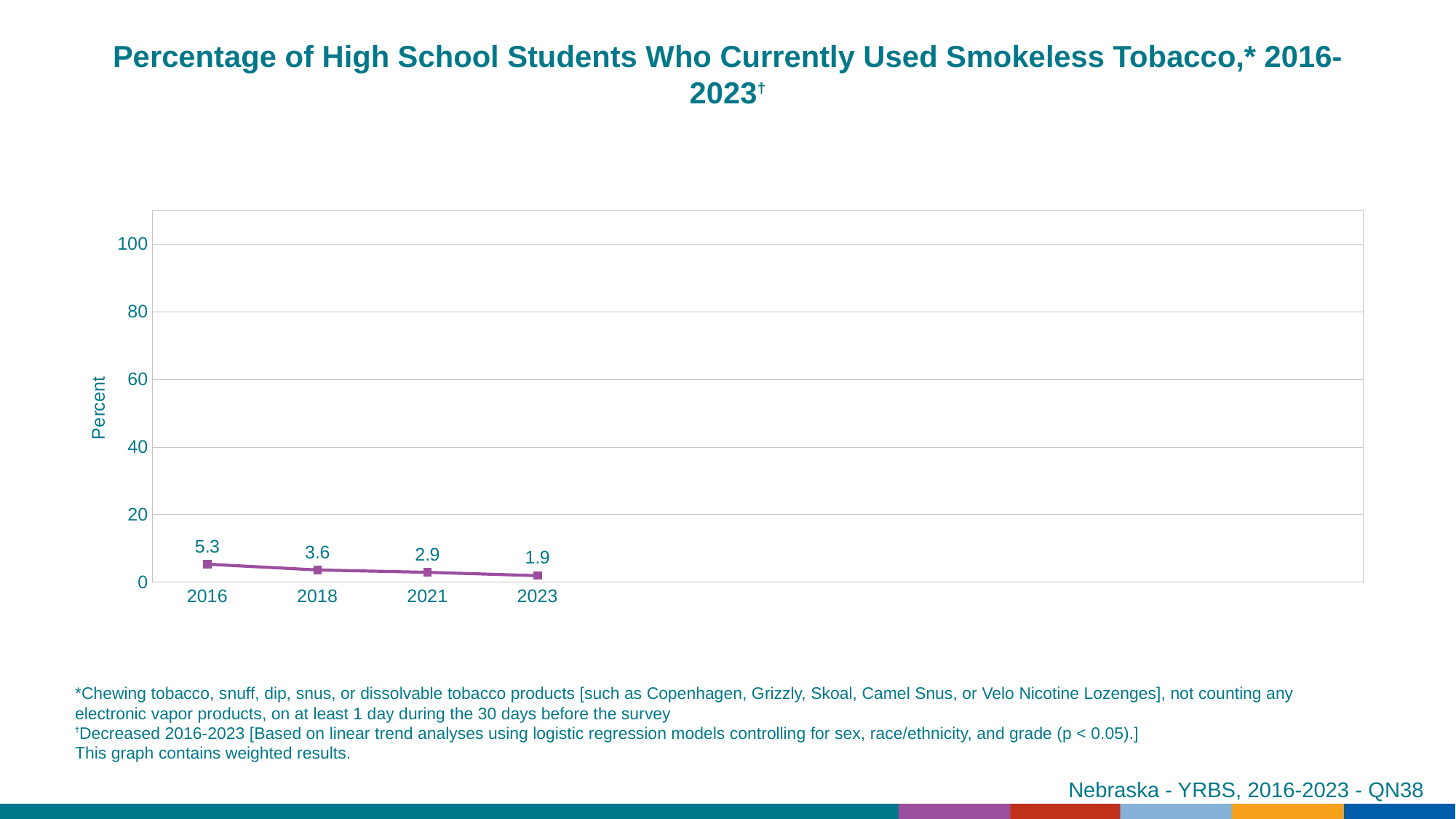
What type of chart is shown on the slide? Line chart What was the percentage of high school students who currently used smokeless tobacco in 2023? 1.9 How many years are plotted on the chart? 4 By how many percentage points did the value change from 2016 to 2023? 3.4 Which year had a higher value, 2018 or 2023? 2018 What was the percentage of high school students who currently used smokeless tobacco in 2018? 3.6 What is the difference between the 2018 and 2021 values? 0.7 In which year was the percentage of students who currently used smokeless tobacco lowest? 2023 Do the values rise or fall from 2016 to 2023? Fall What was the percentage of high school students who currently used smokeless tobacco in 2016? 5.3 In which year was the percentage of students who currently used smokeless tobacco highest? 2016 What was the percentage of high school students who currently used smokeless tobacco in 2021? 2.9